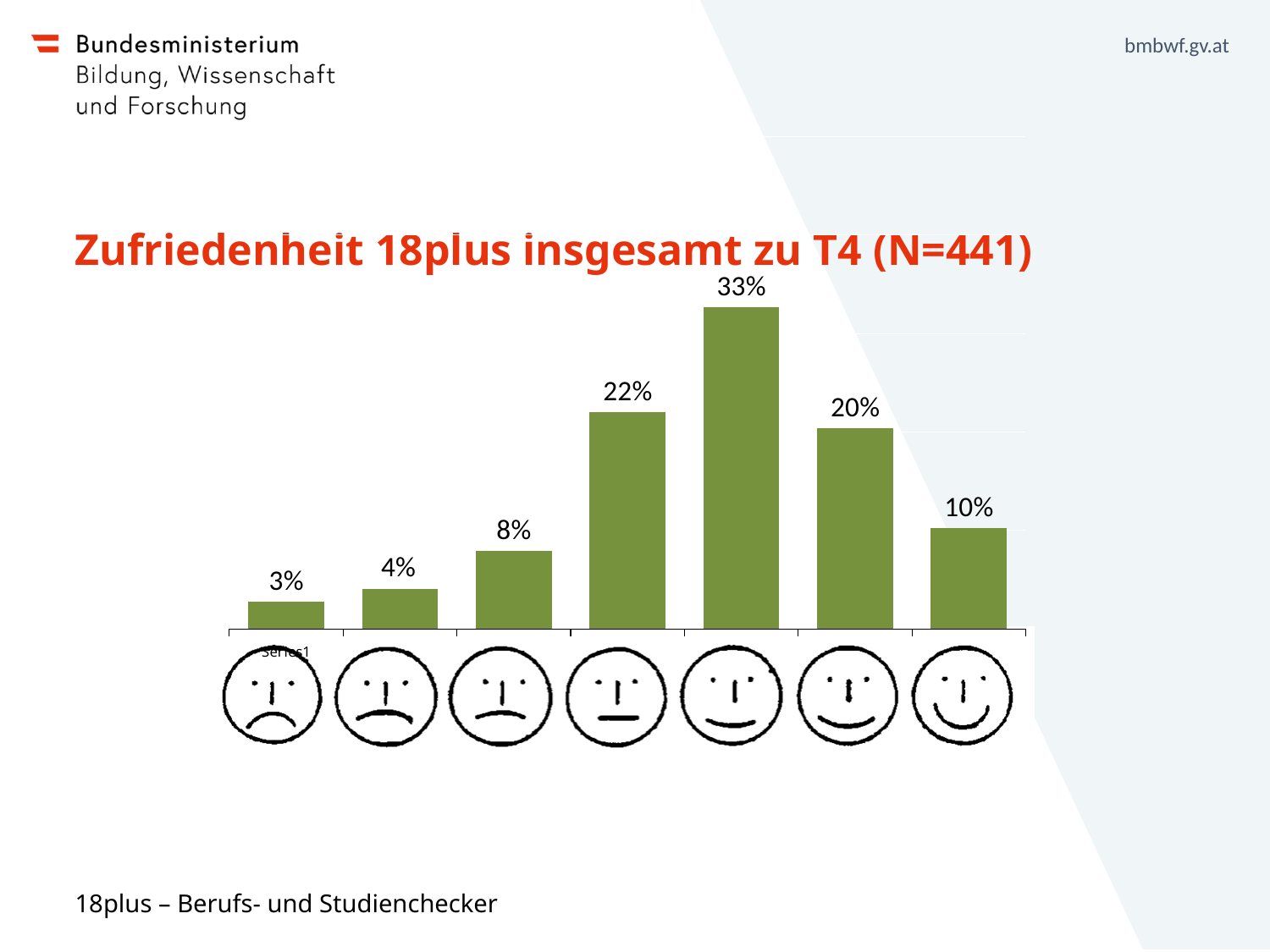
What is the combined value of the two leftmost bars? 7% What is the title of the chart on the slide? Zufriedenheit 18plus insgesamt zu T4 (N=441) What is the difference between the fifth bar (33%) and the fourth bar (22%)? 11% What kind of chart is shown on the slide? bar chart What is the value of the sixth bar from the left? 20% What is the value of the shortest bar in the chart? 3% Which is larger, the value of the third bar from the left or the value of the last bar on the right? the last bar on the right (10%) What is the value of the last bar on the right (the happiest face)? 10% How many bars does the chart contain? 7 What is the value of the fourth bar from the left (the neutral face)? 22% What is the value of the tallest bar in the chart? 33% What is the value of the first bar from the left (the saddest face)? 3%